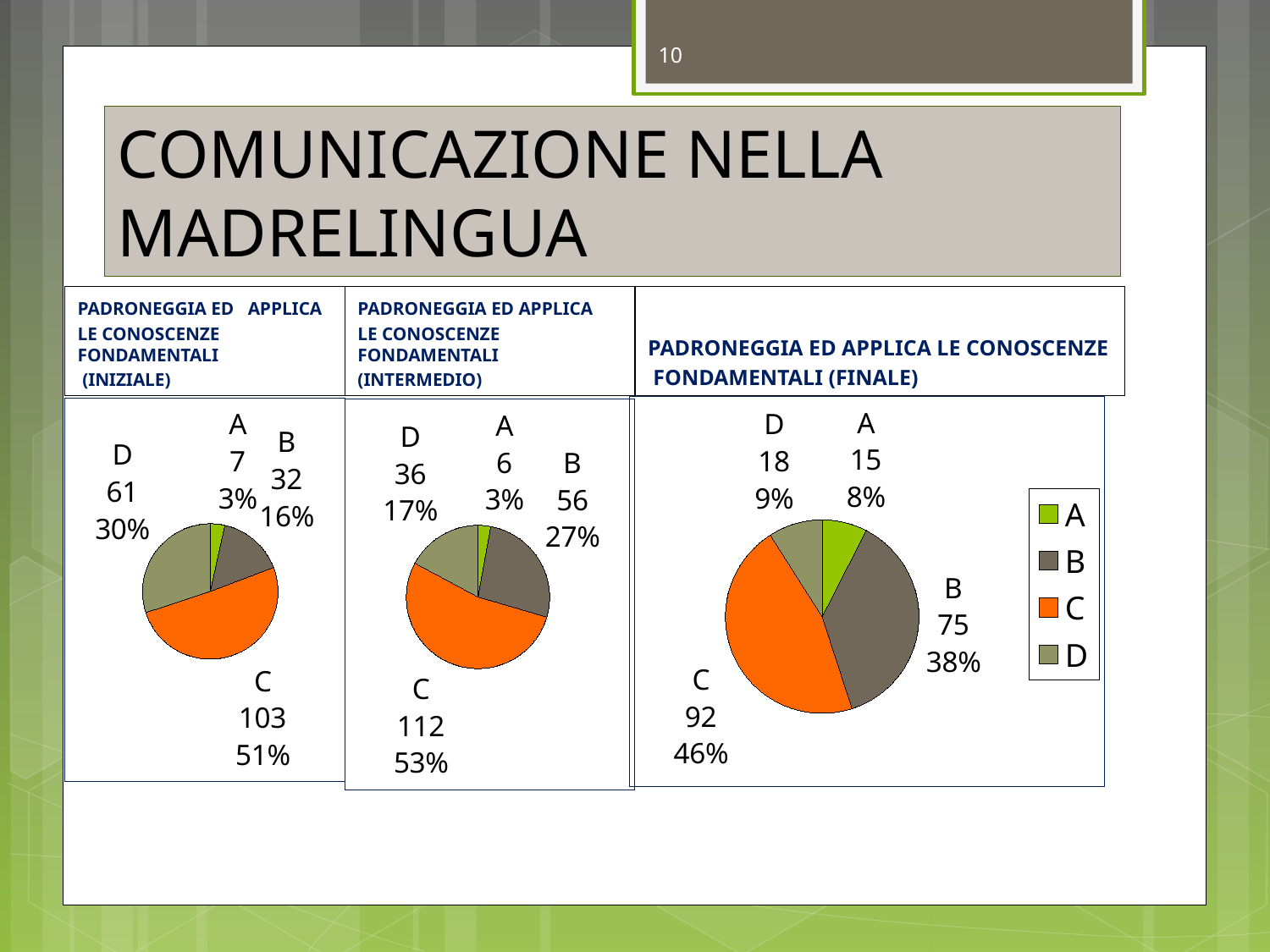
In the INIZIALE pie chart, which is larger, the value for B or the value for D? D In the FINALE pie chart, what is the difference between the values for C and B? 17 How many categories does the legend on the slide list? 4 What kind of charts are shown on the slide? Pie charts In the INTERMEDIO pie chart, which category has the smallest slice? A In the FINALE pie chart, which category has the largest slice? C In the FINALE pie chart, what share of the pie does category B have? 38% In the INTERMEDIO pie chart, what is the value for category B? 56 In the legend, which colour represents category C? Orange In the FINALE pie chart, what is the value for category D? 18 In the INIZIALE pie chart, what is the value for category C? 103 In the INIZIALE pie chart, what share of the pie does category D have? 30%